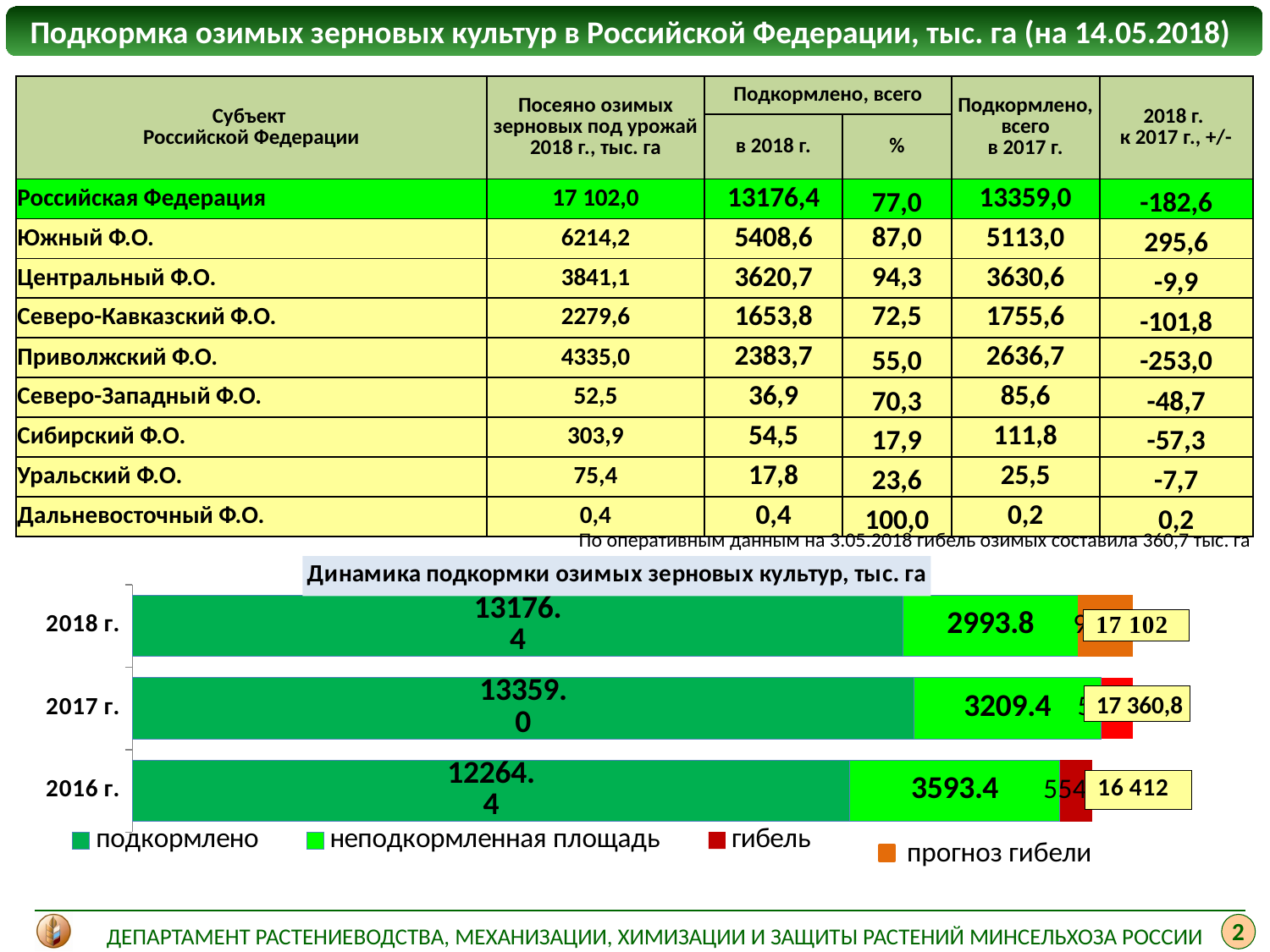
What kind of chart is shown at the bottom of the slide? bar chart How many series does the legend of the bar chart list? 4 What is the title of the bar chart on the slide? Динамика подкормки озимых зерновых культур, тыс. га In the bar chart, what is the value of "неподкормленная площадь" for 2017 г.? 3209.4 In the bar chart, is the "подкормлено" value larger for 2018 г. or for 2016 г.? 2018 г. In the bar chart, which year has the highest value for "подкормлено"? 2017 г. How many years (categories) are plotted in the chart "Динамика подкормки озимых зерновых культур, тыс. га"? 3 In the bar chart, what is the value of "подкормлено" for 2016 г.? 12264.4 In the bar chart, what is the difference between the "подкормлено" values for 2017 г. and 2018 г.? 182.6 In the bar chart, what is the value of "подкормлено" for 2018 г.? 13176.4 In the bar chart, which year has the lowest value for "неподкормленная площадь"? 2018 г.